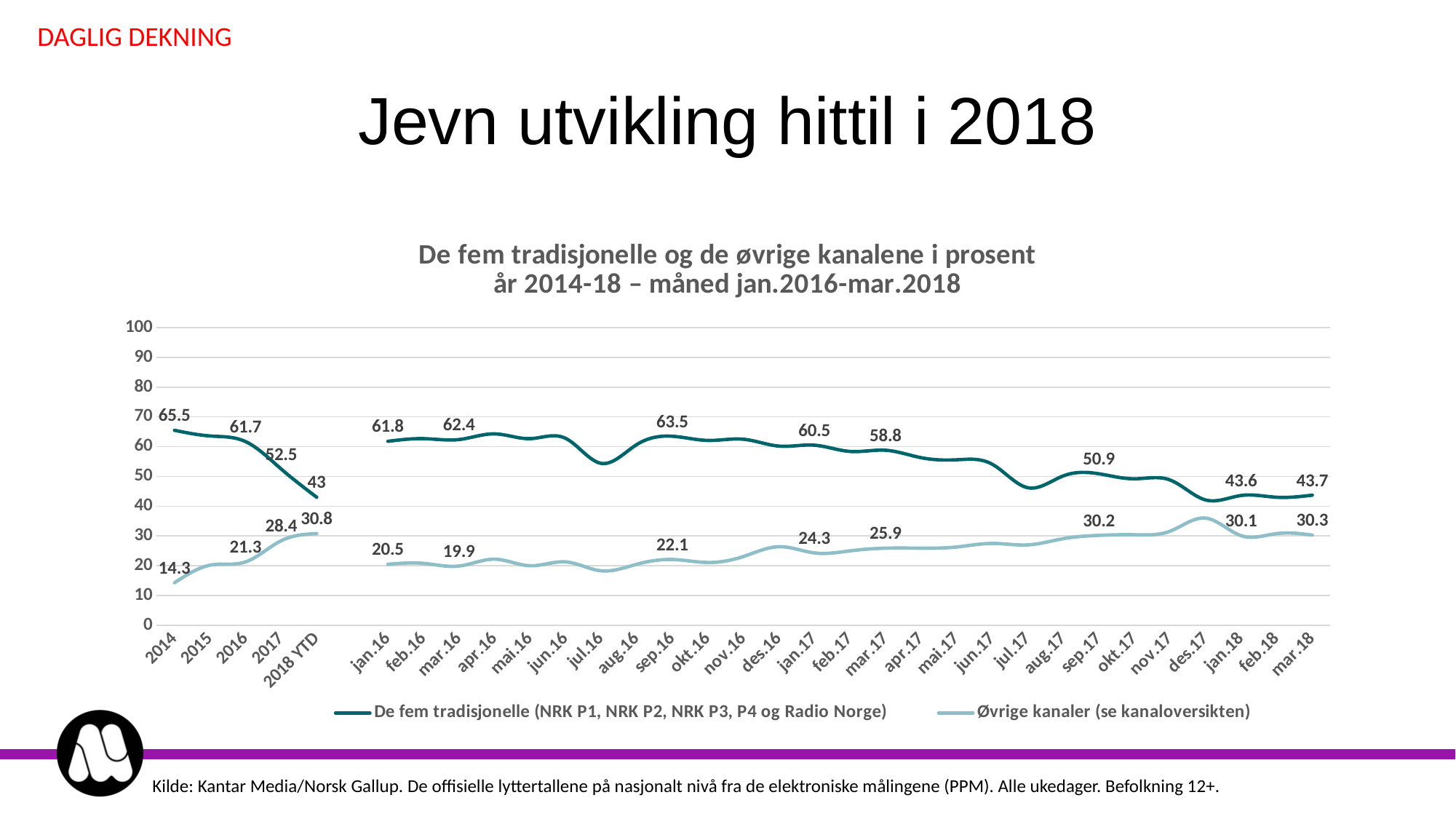
What is the difference between the De fem tradisjonelle values for 2014 and 2018 YTD? 22.5 What is the value for De fem tradisjonelle in 2014? 65.5 What is the value for De fem tradisjonelle in sep.16? 63.5 Is the value for De fem tradisjonelle in jul.17 greater or less than 50? less At which point does Øvrige kanaler have its lowest value? 2014 What is the value for Øvrige kanaler in 2018 YTD? 30.8 In sep.17, which series has the larger value, De fem tradisjonelle or Øvrige kanaler? De fem tradisjonelle What is the value for Øvrige kanaler in mar.18? 30.3 Do the values for De fem tradisjonelle rise or fall from 2014 to 2018 YTD? Fall What is the difference between the Øvrige kanaler values for jan.16 and mar.18? 9.8 What kind of chart is shown on the slide? Line chart How many series does the legend list? 2